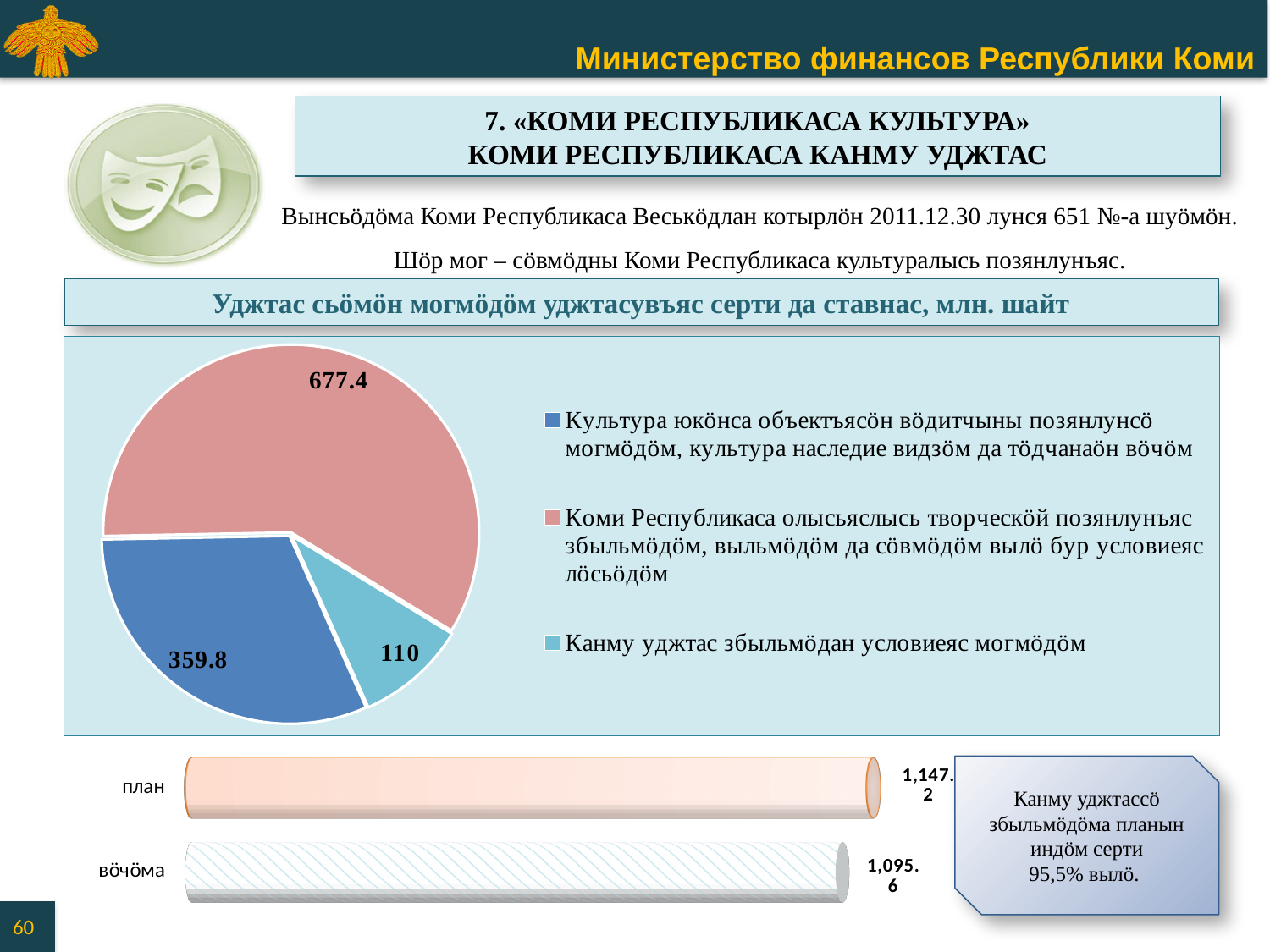
In the pie chart, what is the value of the slice for «Культура юкöнса объектъясöн вöдитчыны позянлунсö могмöдöм, культура наследие видзöм да тöдчанаöн вöчöм»? 359.8 In the pie chart, which is larger: the slice for «Коми Республикаса олысьяслысь творческöй позянлунъяс збыльмöдöм...» or the slice for «Канму уджтас збыльмöдан условиеяс могмöдöм»? Коми Республикаса олысьяслысь творческöй позянлунъяс збыльмöдöм, выльмöдöм да сöвмöдöм вылö бур условиеяс лöсьöдöм In the pie chart, what is the difference between the 677.4 slice and the 359.8 slice? 317.6 In the pie chart, what is the value of the slice for «Канму уджтас збыльмöдан условиеяс могмöдöм»? 110 How many slices does the pie chart have? 3 How many entries does the pie chart legend list? 3 In the pie chart, what is the value of the largest slice? 677.4 In the bar chart at the bottom of the slide, what is the value for «план»? 1,147.2 In the bar chart at the bottom of the slide, what is the difference between «план» and «вöчöма»? 51.6 In the pie chart, what is the value of the smallest slice? 110 What type of chart is shown in the upper part of the slide? pie chart In the bar chart at the bottom of the slide, what is the value for «вöчöма»? 1,095.6